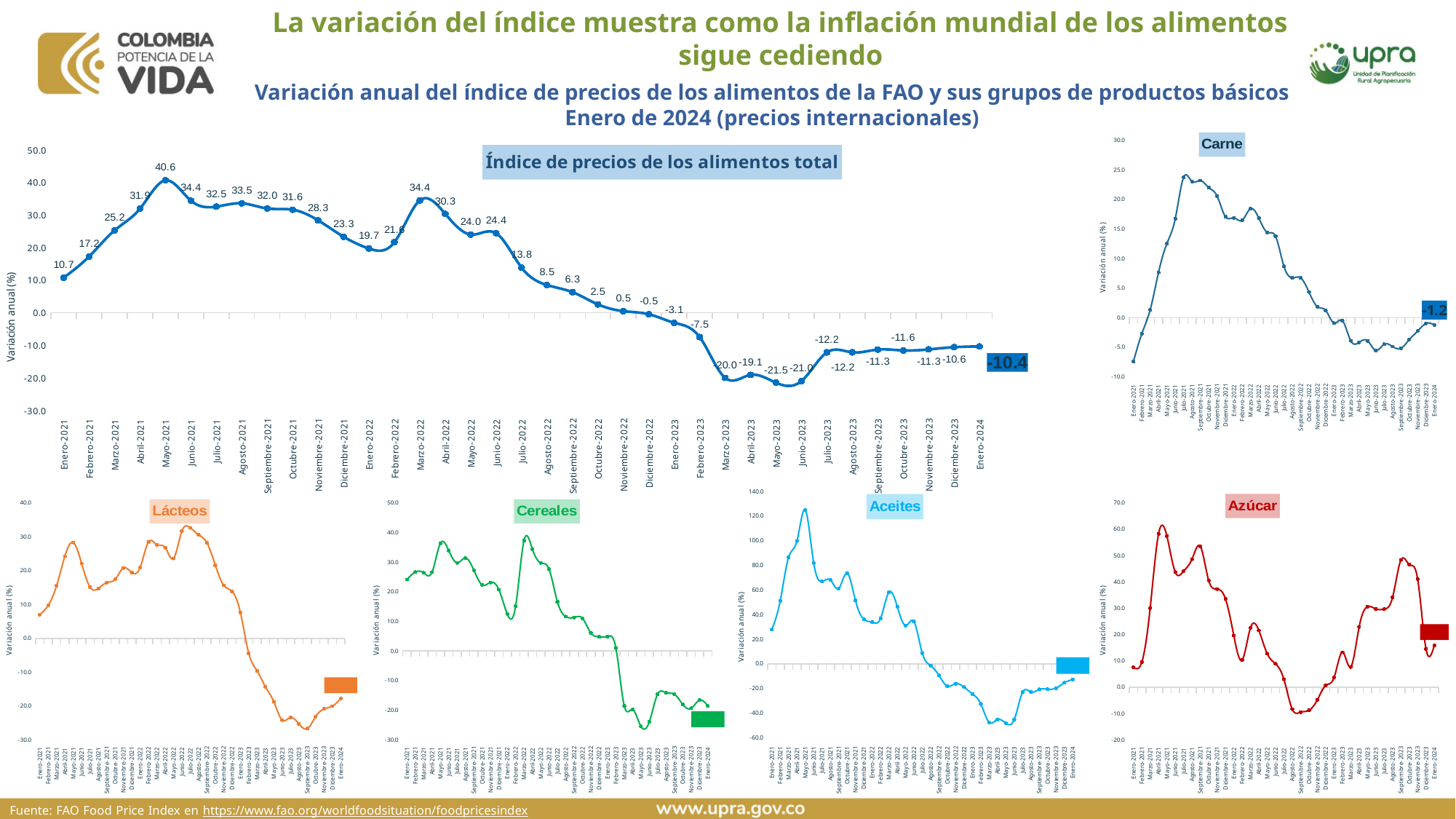
In the 'Índice de precios de los alimentos total' chart, which is larger, the value for Marzo-2022 or Abril-2022? Marzo-2022 In the 'Índice de precios de los alimentos total' chart, which month has the lowest value? Mayo-2023 In the 'Índice de precios de los alimentos total' chart, what is the value for Enero-2024? -10.4 In the 'Aceites' chart, is the value for Enero-2024 greater or less than 0.0? less In the 'Carne' chart, what is the value for Enero-2024? -1.2 In the 'Índice de precios de los alimentos total' chart, what is the difference between the values for Mayo-2021 and Enero-2021? 29.9 How many charts are shown on the slide? 6 In the 'Índice de precios de los alimentos total' chart, which month has the highest value? Mayo-2021 What kind of chart is the 'Índice de precios de los alimentos total' chart? Line chart In the 'Índice de precios de los alimentos total' chart, do the values rise or fall from Marzo-2022 to Mayo-2023? Fall How many data points are plotted in the 'Índice de precios de los alimentos total' chart? 37 In the 'Índice de precios de los alimentos total' chart, what is the value for Mayo-2021? 40.6